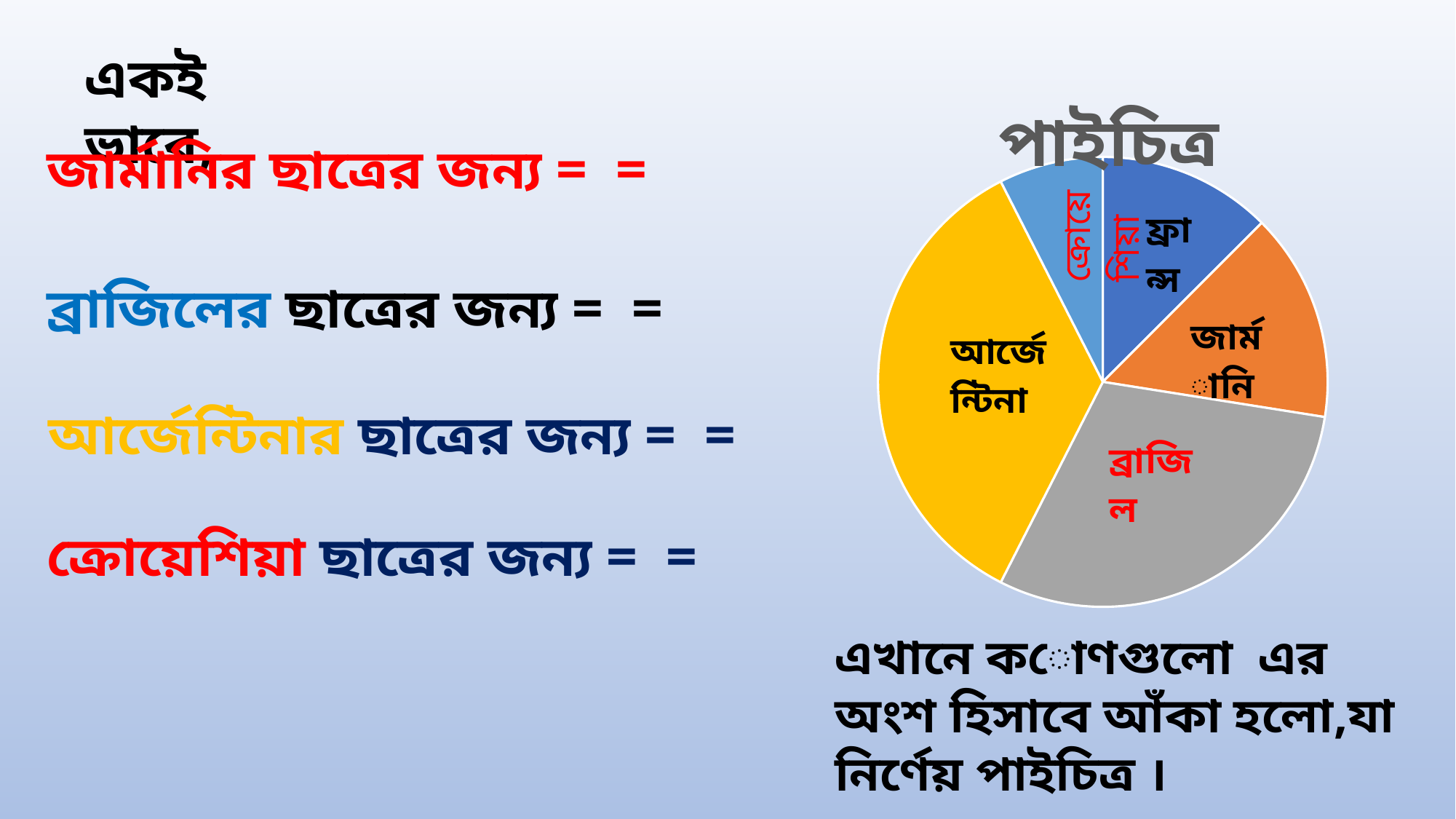
What colour is the আর্জেন্টিনা slice in the pie chart? yellow What is the title of the pie chart? পাইচিত্র What kind of chart is shown on the slide? pie chart Which slice of the pie chart is the smallest? ক্রোয়েশিয়া How many slices does the pie chart have? 5 Which slice is larger in the pie chart, ব্রাজিল or জার্মানি? ব্রাজিল Which slice is larger in the pie chart, ফ্রান্স or ক্রোয়েশিয়া? ফ্রান্স Which slice of the pie chart is the largest? আর্জেন্টিনা Which slice is larger in the pie chart, আর্জেন্টিনা or ব্রাজিল? আর্জেন্টিনা